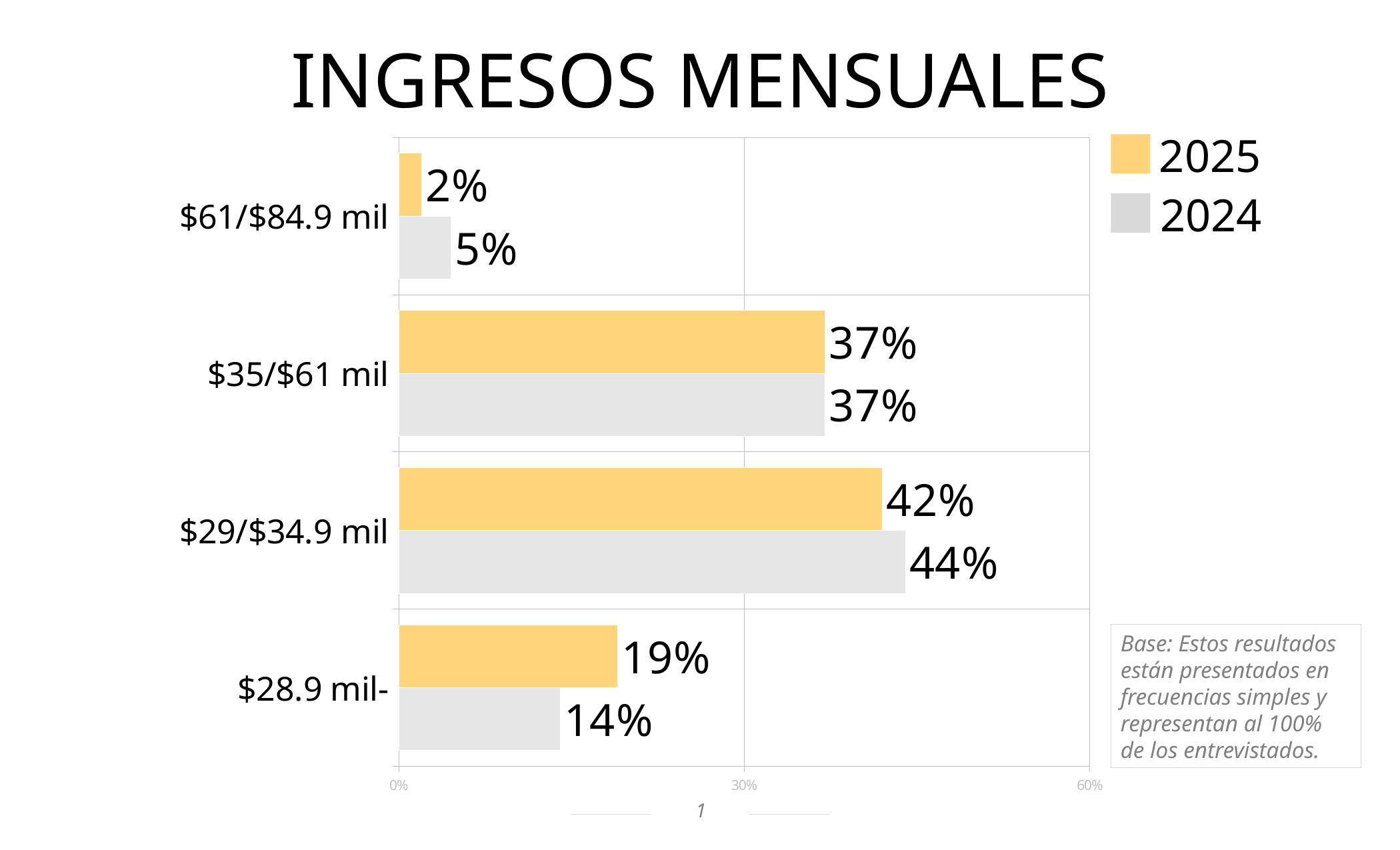
Which category has the highest 2025 value? $29/$34.9 mil What is the 2024 value for $35/$61 mil? 37% What is the 2025 value for $61/$84.9 mil? 2% What is the 2024 value for $28.9 mil-? 14% Which category has the lowest 2024 value? $61/$84.9 mil What kind of chart is shown on the slide? Bar chart What is the 2025 value for $29/$34.9 mil? 42% What is the difference between the 2024 and 2025 values for $28.9 mil-? 5% What is the title of the chart? INGRESOS MENSUALES How many income categories are shown on the chart? 4 How many series does the legend list? 2 Which is larger for $29/$34.9 mil, the 2025 value or the 2024 value? 2024